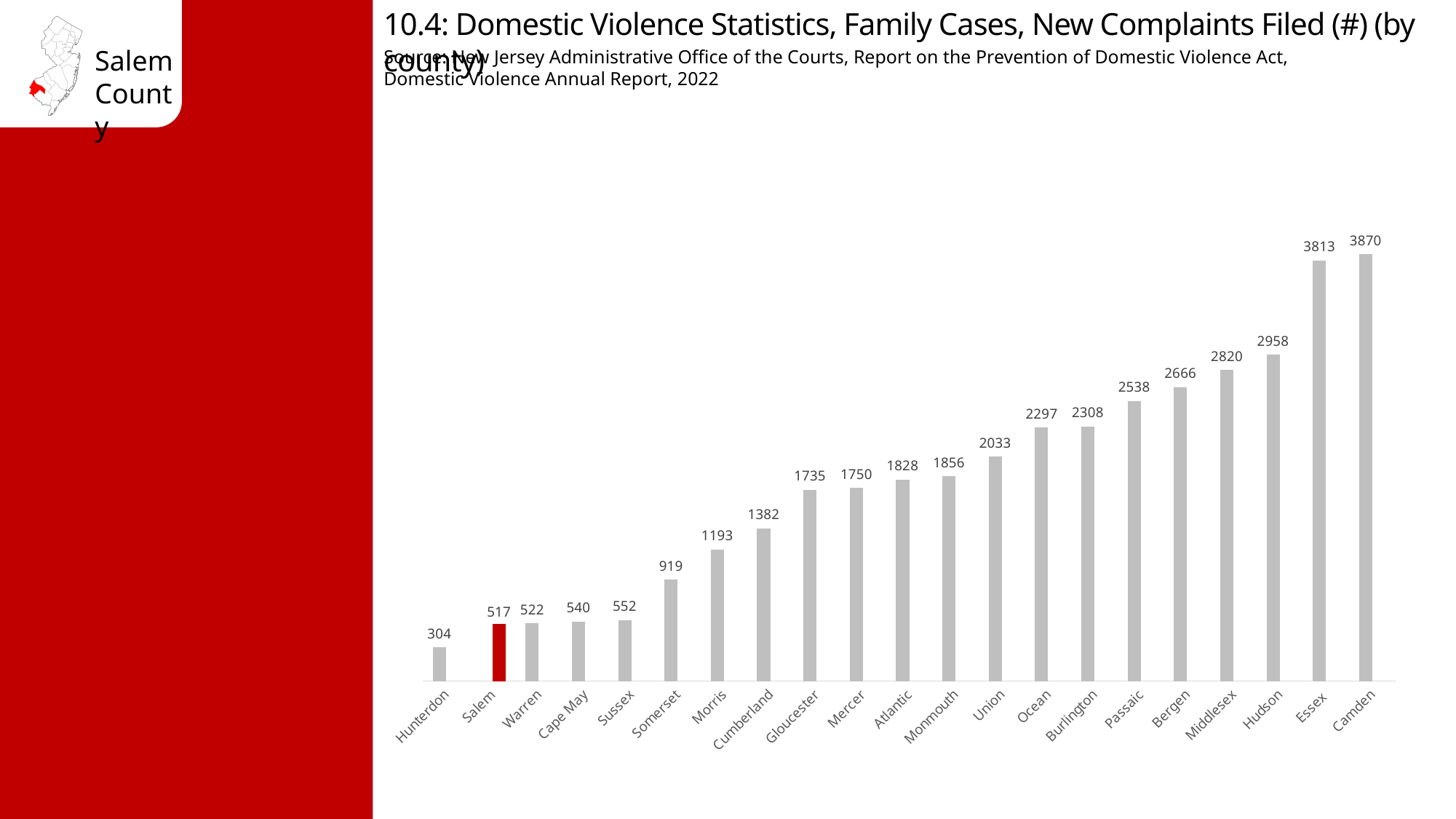
Which has a larger value, Hudson or Middlesex? Hudson Which county's bar is highlighted in red? Salem Which county has the lowest number of new complaints filed? Hunterdon What is the number of new domestic violence family case complaints filed in Salem County? 517 How many counties are shown on the chart? 21 What is the difference between the values for Camden and Essex? 57 What is the value shown for Gloucester? 1735 Which has a larger value, Cumberland or Morris? Cumberland What kind of chart is shown on the slide? Bar chart What is the value shown for Camden? 3870 What is the difference between the values for Salem and Hunterdon? 213 Which county has the highest number of new complaints filed? Camden